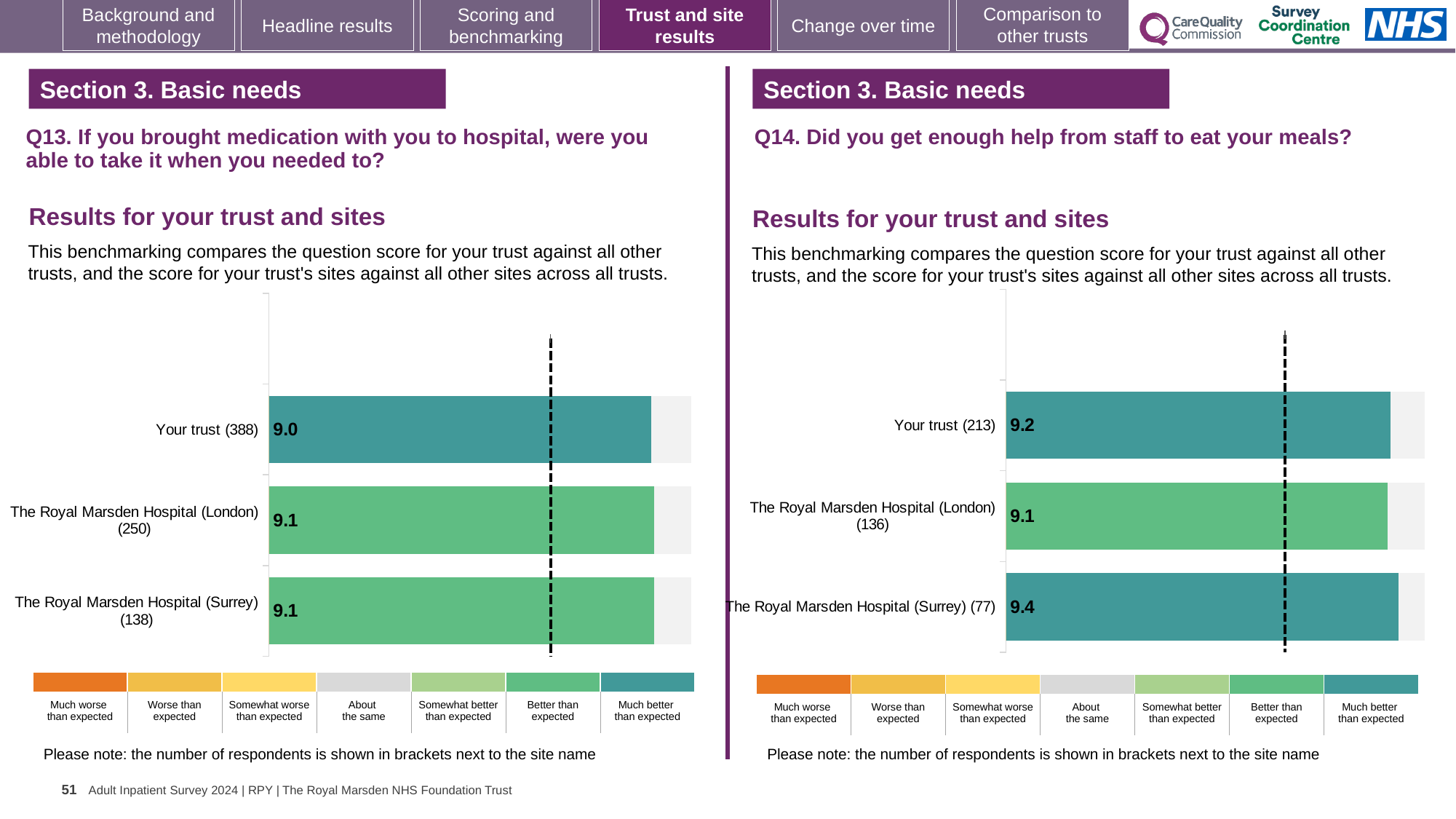
In the Q13 chart (left), what is the score for The Royal Marsden Hospital (Surrey) (138)? 9.1 In the Q13 chart (left), which category has the lowest score? Your trust (388) In the Q13 chart (left), what is the score for Your trust (388)? 9.0 In the Q13 chart (left), which is larger: the score for Your trust (388) or The Royal Marsden Hospital (London) (250)? The Royal Marsden Hospital (London) (250) In the Q14 chart (right), which category has the lowest score? The Royal Marsden Hospital (London) (136) How many categories are plotted in the Q13 chart (left)? 3 In the Q14 chart (right), which category has the highest score? The Royal Marsden Hospital (Surrey) (77) How many respondents are shown in brackets for The Royal Marsden Hospital (London) in the Q14 chart (right)? 136 In the Q14 chart (right), what is the score for The Royal Marsden Hospital (Surrey) (77)? 9.4 In the Q14 chart (right), what is the score for Your trust (213)? 9.2 What kind of chart is the Q14 chart (right)? Bar chart In the Q14 chart (right), what is the difference between the scores for The Royal Marsden Hospital (Surrey) (77) and The Royal Marsden Hospital (London) (136)? 0.3